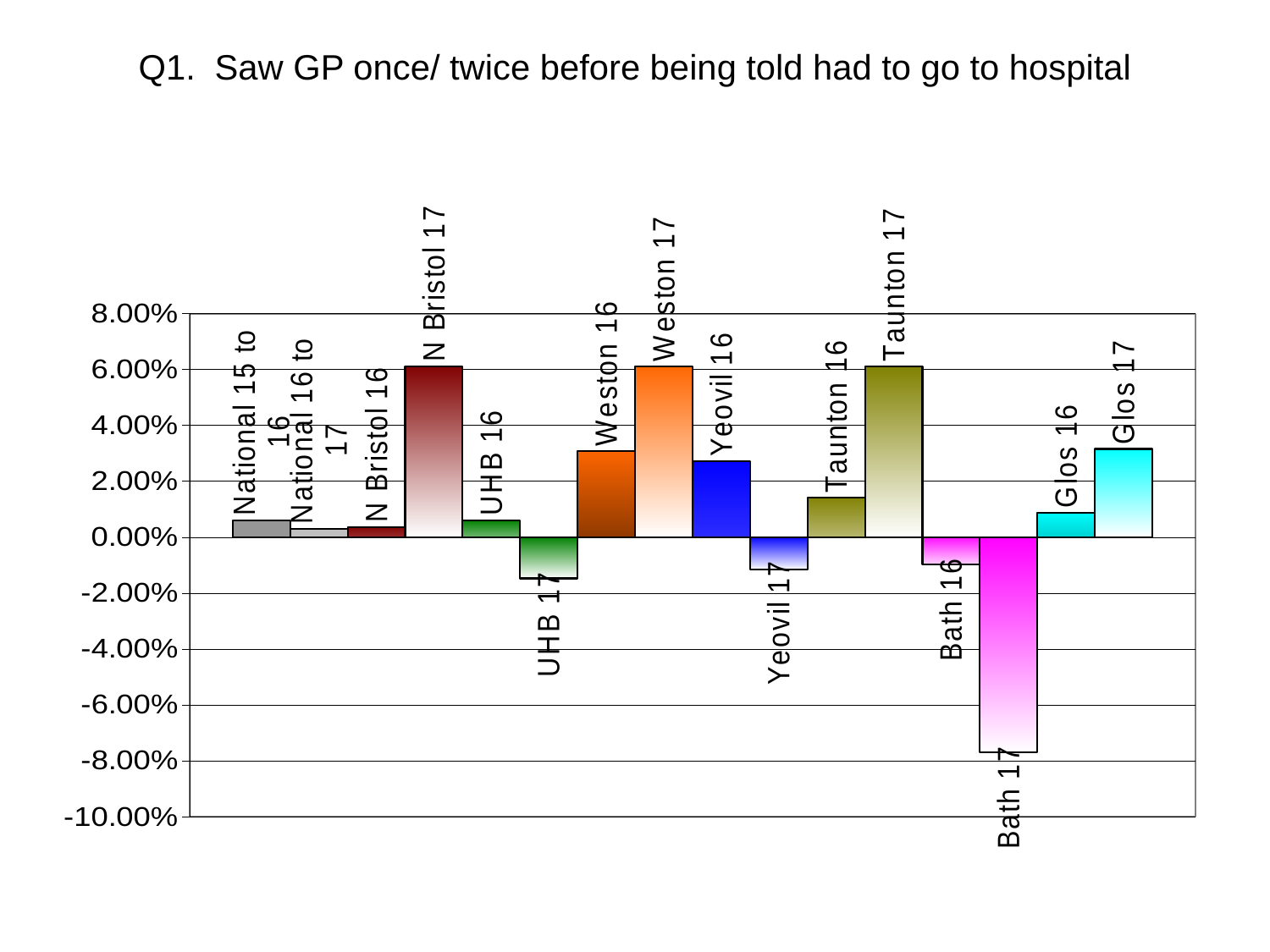
Which is larger, the value for Glos 16 or Glos 17? Glos 17 Which category has the lowest value in the chart? Bath 17 Is the value for Taunton 16 greater or less than 2.00%? less How many bars are plotted in the chart? 16 Is the value for N Bristol 17 greater or less than 4.00%? greater Is the value for Weston 16 greater or less than 2.00%? greater What kind of chart is shown on the slide? bar chart Which is larger, the value for Weston 16 or Weston 17? Weston 17 Which is larger, the value for Bath 16 or Bath 17? Bath 16 What is the title of the chart? Q1. Saw GP once/ twice before being told had to go to hospital